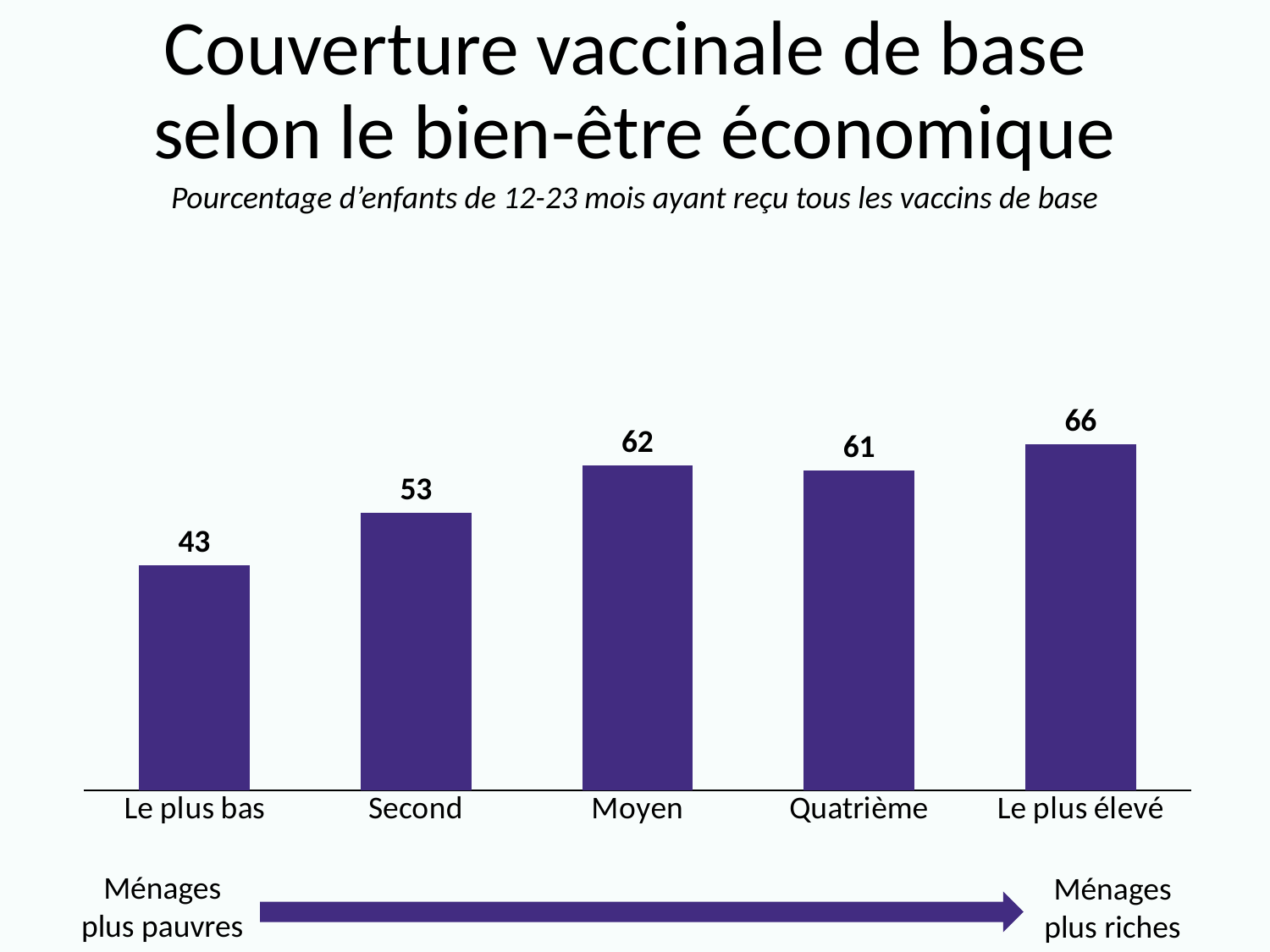
What is the difference between the values for Le plus élevé and Le plus bas? 23 What kind of chart is shown on the slide? Bar chart What is the value for Le plus élevé? 66 How many categories are shown on the chart? 5 Which is larger, the value for Second or the value for Moyen? Moyen What is the value for Second? 53 Which category has the lowest value? Le plus bas What is the title of the chart? Couverture vaccinale de base selon le bien-être économique What is the value for Moyen? 62 What is the value for Quatrième? 61 What is the value for Le plus bas? 43 Which category has the highest value? Le plus élevé